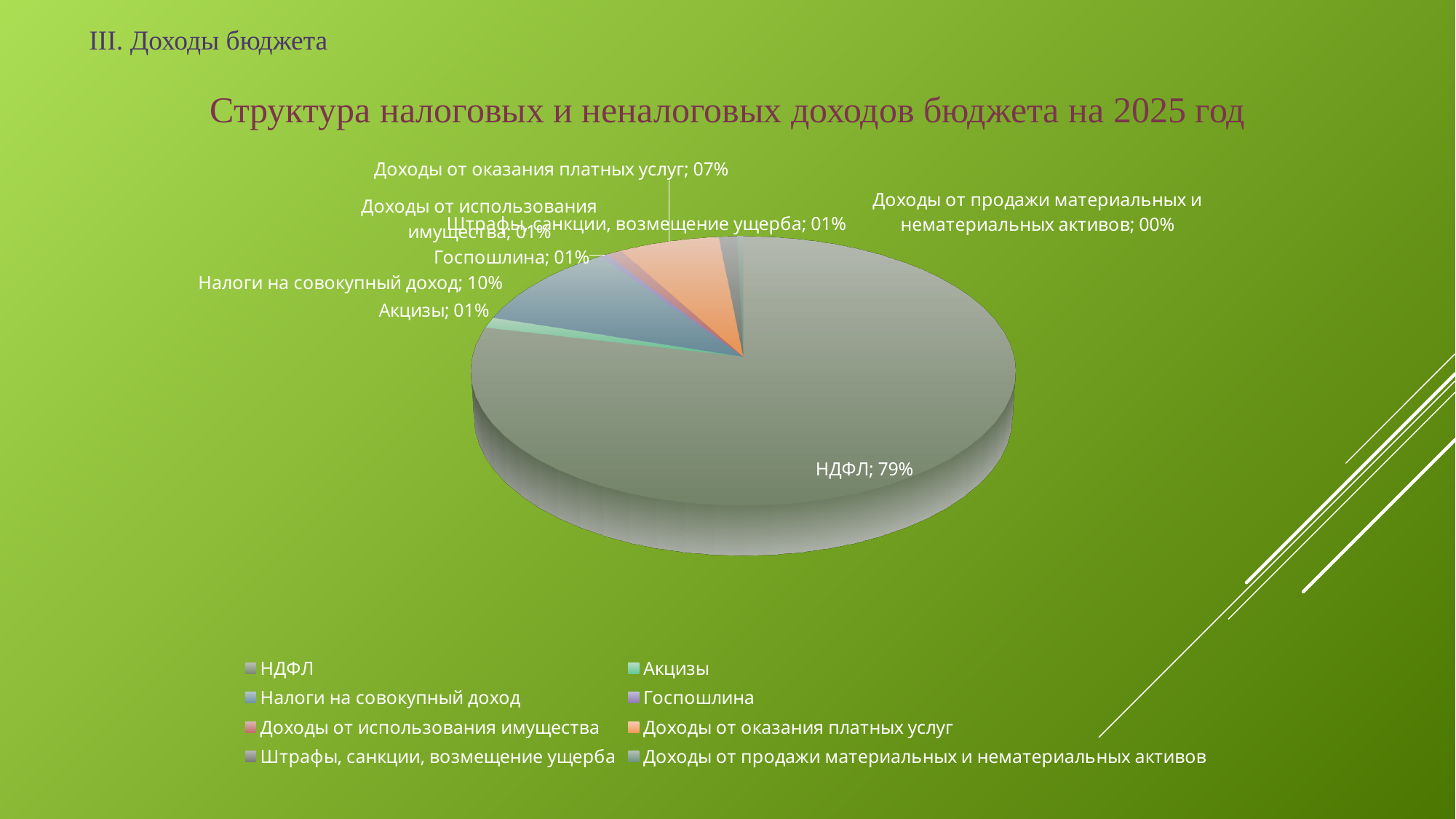
How many categories does the legend list? 8 What is the value shown for Акцизы? 01% What is the value shown for Доходы от оказания платных услуг? 07% What type of chart is shown on the slide? Pie chart Which is larger: Налоги на совокупный доход or Доходы от оказания платных услуг? Налоги на совокупный доход What is the title of the chart? Структура налоговых и неналоговых доходов бюджета на 2025 год What is the difference in percentage points between НДФЛ and Налоги на совокупный доход? 69 Which category has the smallest share of the pie? Доходы от продажи материальных и нематериальных активов Which category has the largest share of the pie? НДФЛ What is the value shown for Налоги на совокупный доход? 10% What share of the pie does НДФЛ account for? 79% What is the value shown for Доходы от продажи материальных и нематериальных активов? 00%